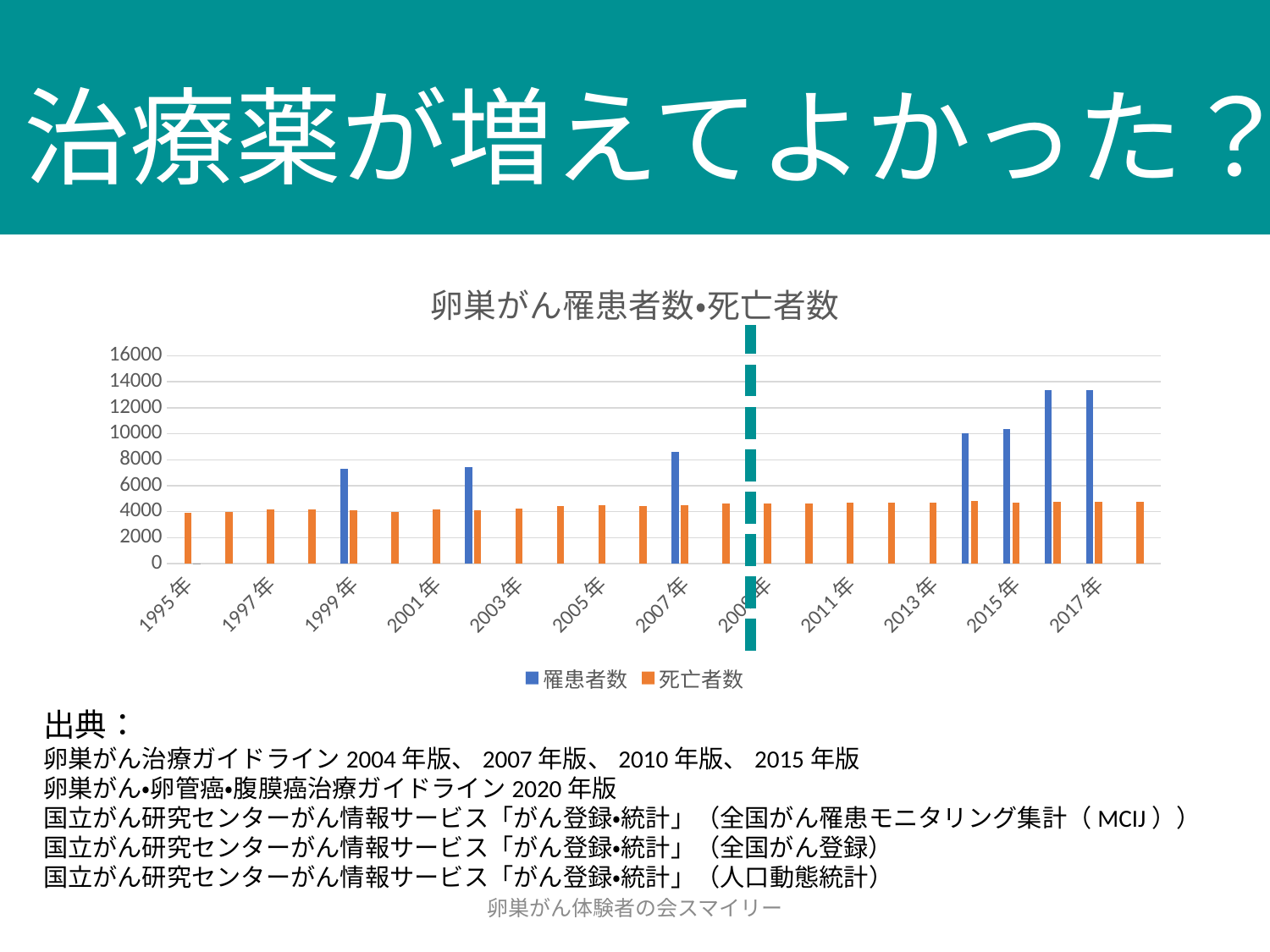
Is the value of 罹患者数 for 2016年 greater or less than 12000? greater What is the title of the chart? 卵巣がん罹患者数•死亡者数 How many series does the legend list? 2 Which series is shown in orange in the legend? 死亡者数 What kind of chart is shown on the slide? bar chart Which is larger, the 罹患者数 value for 2007年 or for 1999年? 2007年 Which is larger, the 罹患者数 value for 2016年 or for 2015年? 2016年 Is the value of 罹患者数 for 1999年 greater or less than 6000? greater Is the value of 死亡者数 for 2017年 greater or less than 4000? greater Do the 死亡者数 values generally rise or fall from 1995年 to 2018年? rise